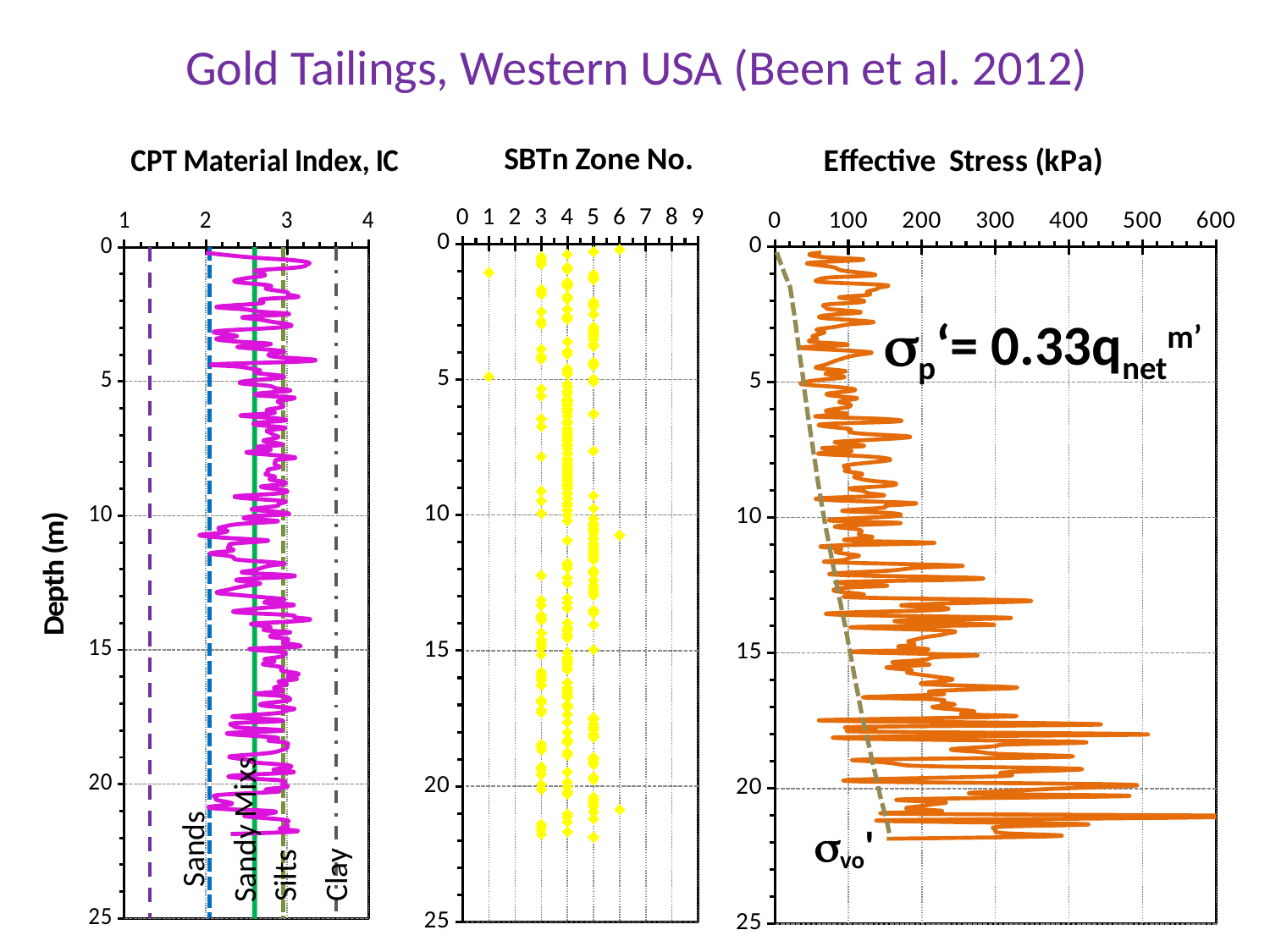
What kind of chart is the Effective Stress (kPa) chart? line chart What kind of chart is the SBTn Zone No. chart? scatter chart In the Effective Stress (kPa) chart, is the effective stress at 5 m depth greater or less than 200? less In the CPT Material Index, IC chart, is the IC value at about 10.8 m depth greater or less than 2.5? less In the SBTn Zone No. chart, which zone number has the most plotted points? 4 In the CPT Material Index, IC chart, what is the deepest depth shown on the vertical axis? 25 In the Effective Stress (kPa) chart, what is the largest value shown on the horizontal axis? 600 In the Effective Stress (kPa) chart, does the effective stress generally increase or decrease with depth? increase What is the title of the slide? Gold Tailings, Western USA (Been et al. 2012) How many charts are shown on the slide? 3 In the CPT Material Index, IC chart, which material label is attached to the dash-dot reference line near IC = 3.6? Clay In the Effective Stress (kPa) chart, is the peak effective stress near 21 m depth greater or less than 500? greater